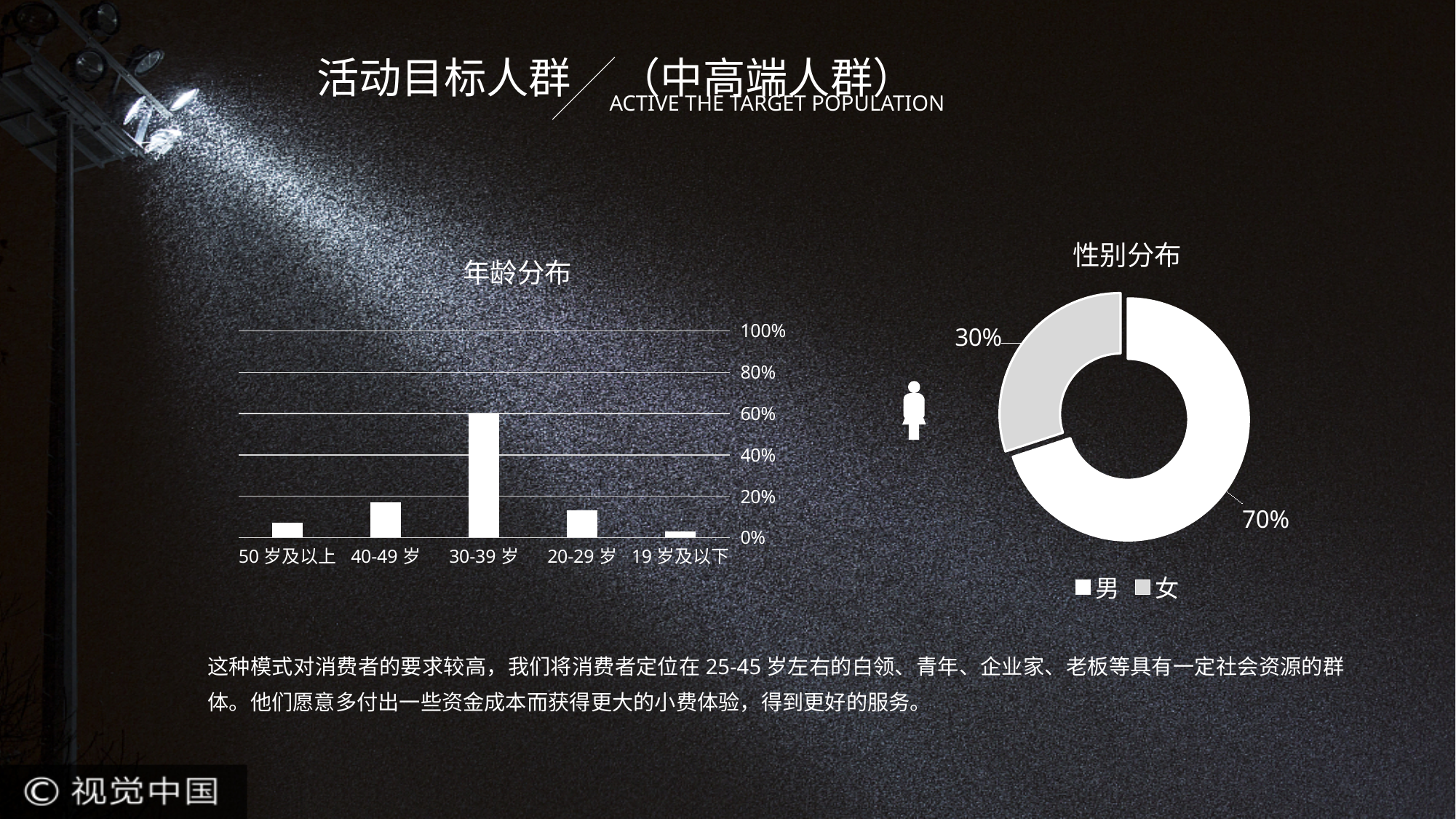
How many age groups are shown in the 年龄分布 chart? 5 In the 年龄分布 chart, which is larger, the value for 40-49 岁 or the value for 20-29 岁? 40-49 岁 How many entries does the legend of the 性别分布 chart list? 2 In the 性别分布 chart, what is the difference between the shares for 男 and 女? 40% In the 年龄分布 chart, which age group has the highest value? 30-39 岁 In the 年龄分布 chart, is the value for 40-49 岁 greater or less than 20%? less In the 年龄分布 chart, is the value for 30-39 岁 greater or less than 40%? greater In the 性别分布 chart, what is the share for 女? 30% In the 年龄分布 chart, which age group has the lowest value? 19 岁及以下 In the 性别分布 chart, what is the share for 男? 70% What kind of chart is the 年龄分布 chart? bar chart In the 年龄分布 chart, is the value for 50 岁及以上 greater or less than 20%? less